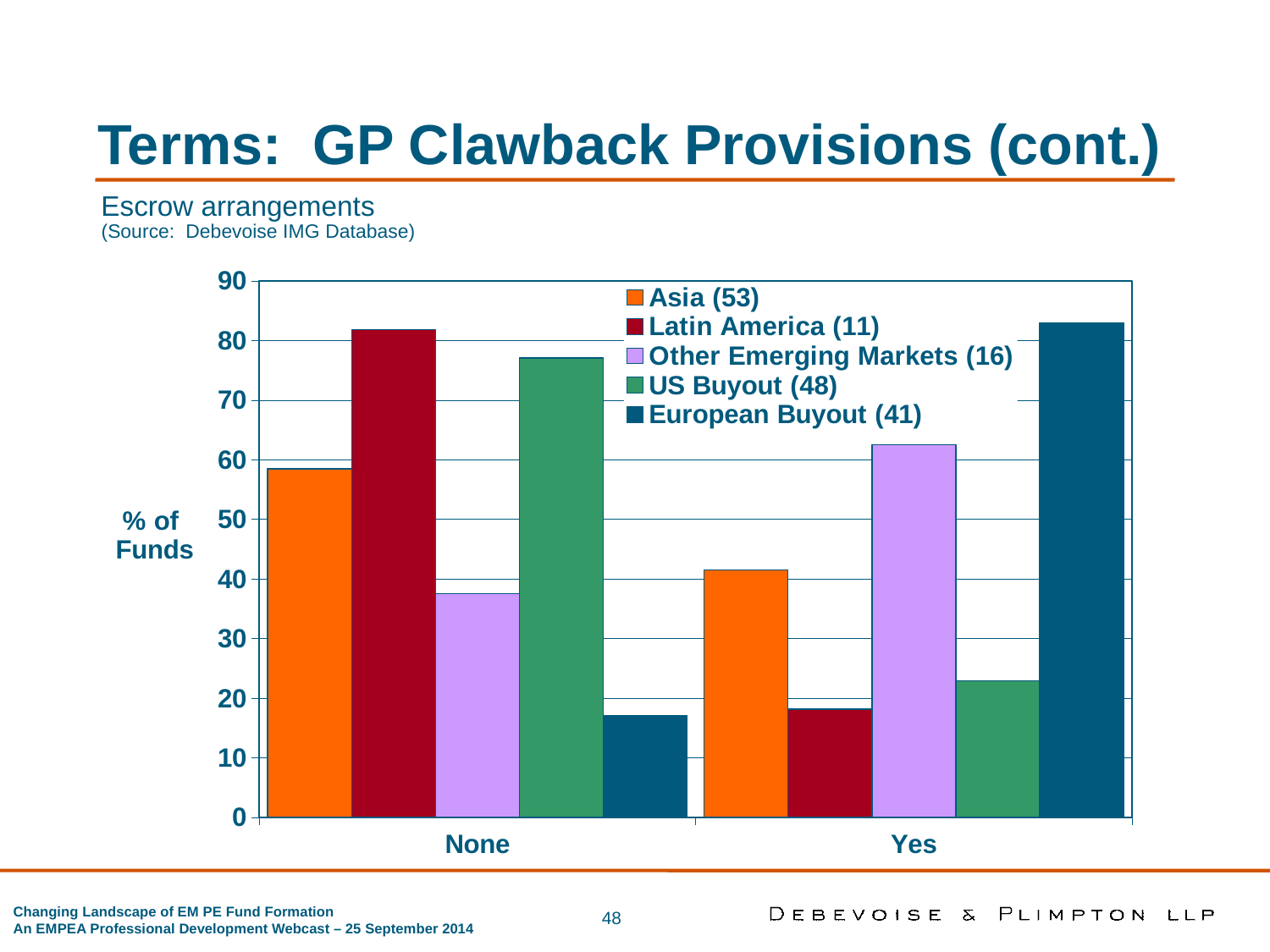
Which series has the lowest value in the None category? European Buyout (41) How many categories are shown on the x axis? 2 Is the value for European Buyout (41) in the Yes category greater or less than 80? greater What is the label on the y axis? % of Funds Which series has the highest value in the None category? Latin America (11) Is the value for Asia (53) in the None category greater or less than 50? greater Which series has the lowest value in the Yes category? Latin America (11) Which is larger: the value for US Buyout (48) in the None category or in the Yes category? None Is the value for Other Emerging Markets (16) in the None category greater or less than 40? less Which series has the highest value in the Yes category? European Buyout (41) How many series does the legend list? 5 What kind of chart is shown on the slide? bar chart